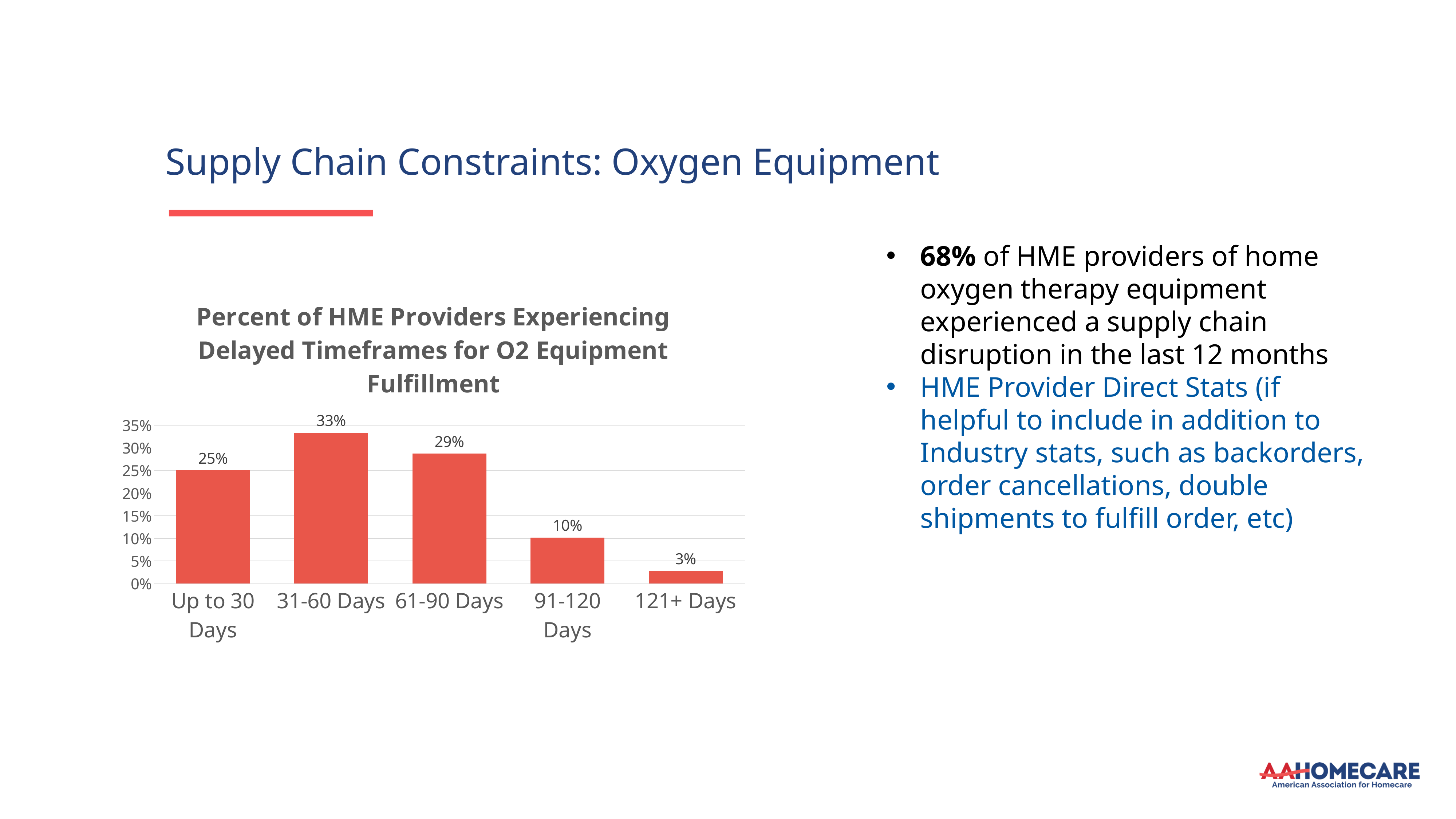
How many categories are shown on the x axis? 5 What percentage of HME providers experienced delayed timeframes of 31-60 Days? 33% What is the difference between the values for Up to 30 Days and 121+ Days? 22% What is the value for the 121+ Days category? 3% Is the value for 91-120 Days greater or less than 15%? less Which category has the highest value? 31-60 Days Which category has the lowest value? 121+ Days What is the value for the 91-120 Days category? 10% Which is larger, the value for Up to 30 Days or the value for 61-90 Days? 61-90 Days What is the title of the chart? Percent of HME Providers Experiencing Delayed Timeframes for O2 Equipment Fulfillment What is the difference between the values for 31-60 Days and 61-90 Days? 4% What kind of chart is shown on the slide? bar chart